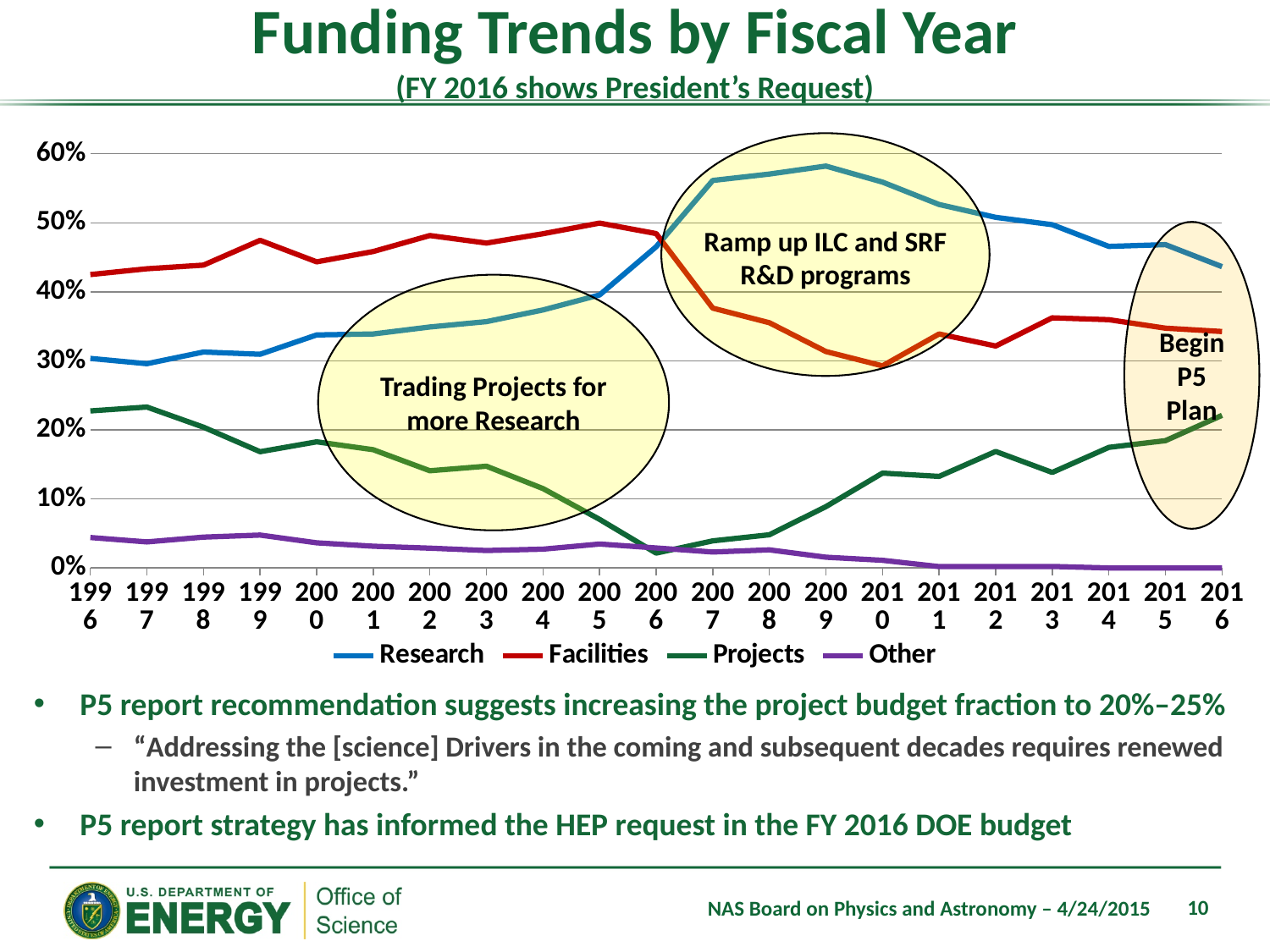
Which series has the lowest value in 2016? Other Is the value for Facilities in 1996 greater or less than 40%? greater What kind of chart is shown on the slide? line chart How many fiscal years are plotted along the x axis? 21 What is the title of the chart on the slide? Funding Trends by Fiscal Year Which series has the highest value in 2009? Research Is the value for Research in 2009 greater or less than 50%? greater Is the value for Projects in 2006 greater or less than 10%? less How many series does the chart legend list? 4 Does the Other series rise or fall from 1996 to 2016? fall In 2000, which is larger: Facilities or Research? Facilities